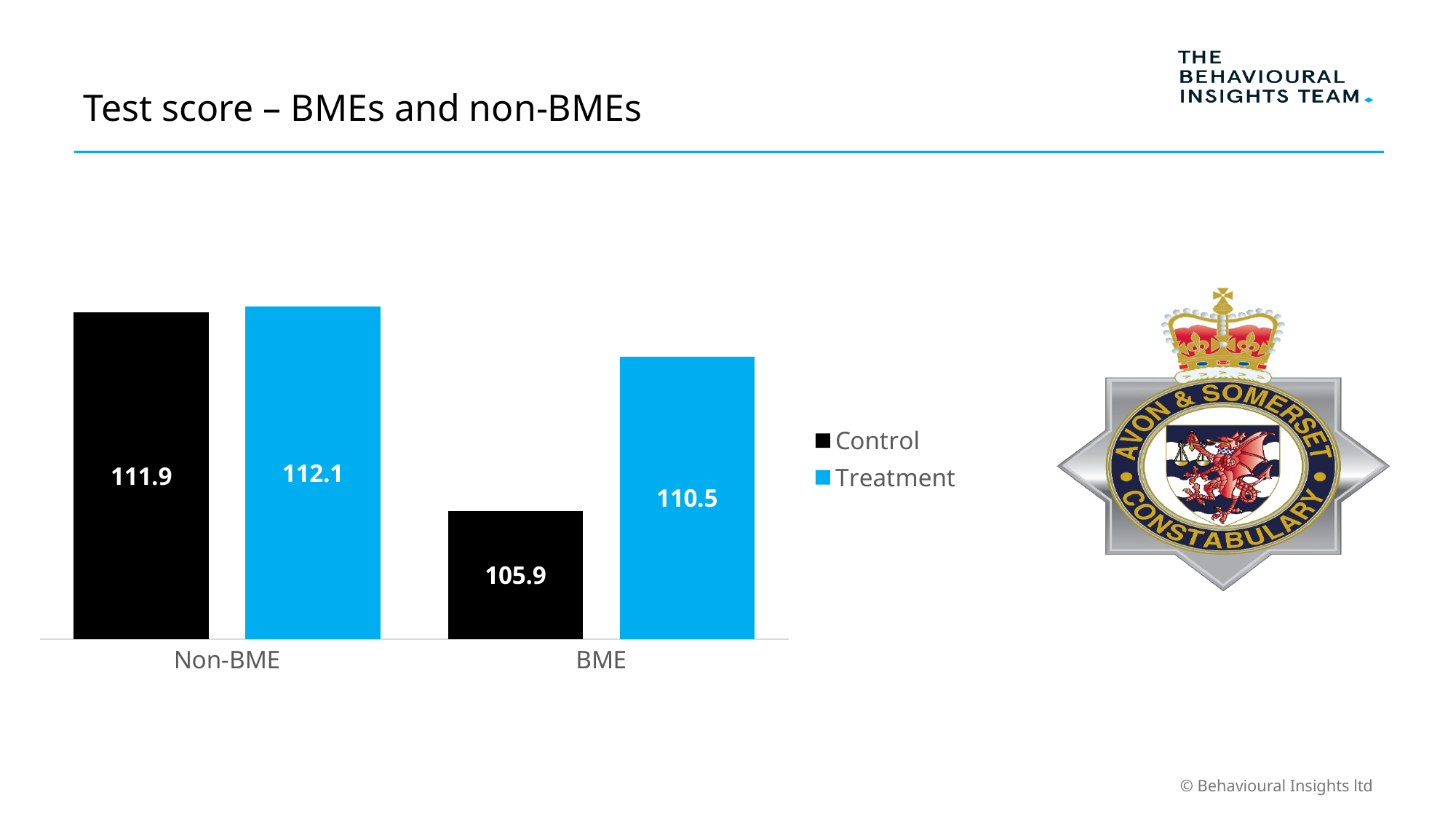
What colour are the Treatment bars? Blue What is the Treatment test score for Non-BME? 112.1 How many categories are shown on the x axis? 2 What kind of chart is shown on the slide? Bar chart What is the Control test score for Non-BME? 111.9 Which is larger for BME: the Control score or the Treatment score? Treatment What is the Treatment test score for BME? 110.5 What is the Control test score for BME? 105.9 Which bar has the lowest value on the chart? BME Control What is the difference between the Non-BME Control score and the BME Control score? 6.0 How many series does the legend list? 2 What is the difference between the Treatment and Control scores for BME? 4.6